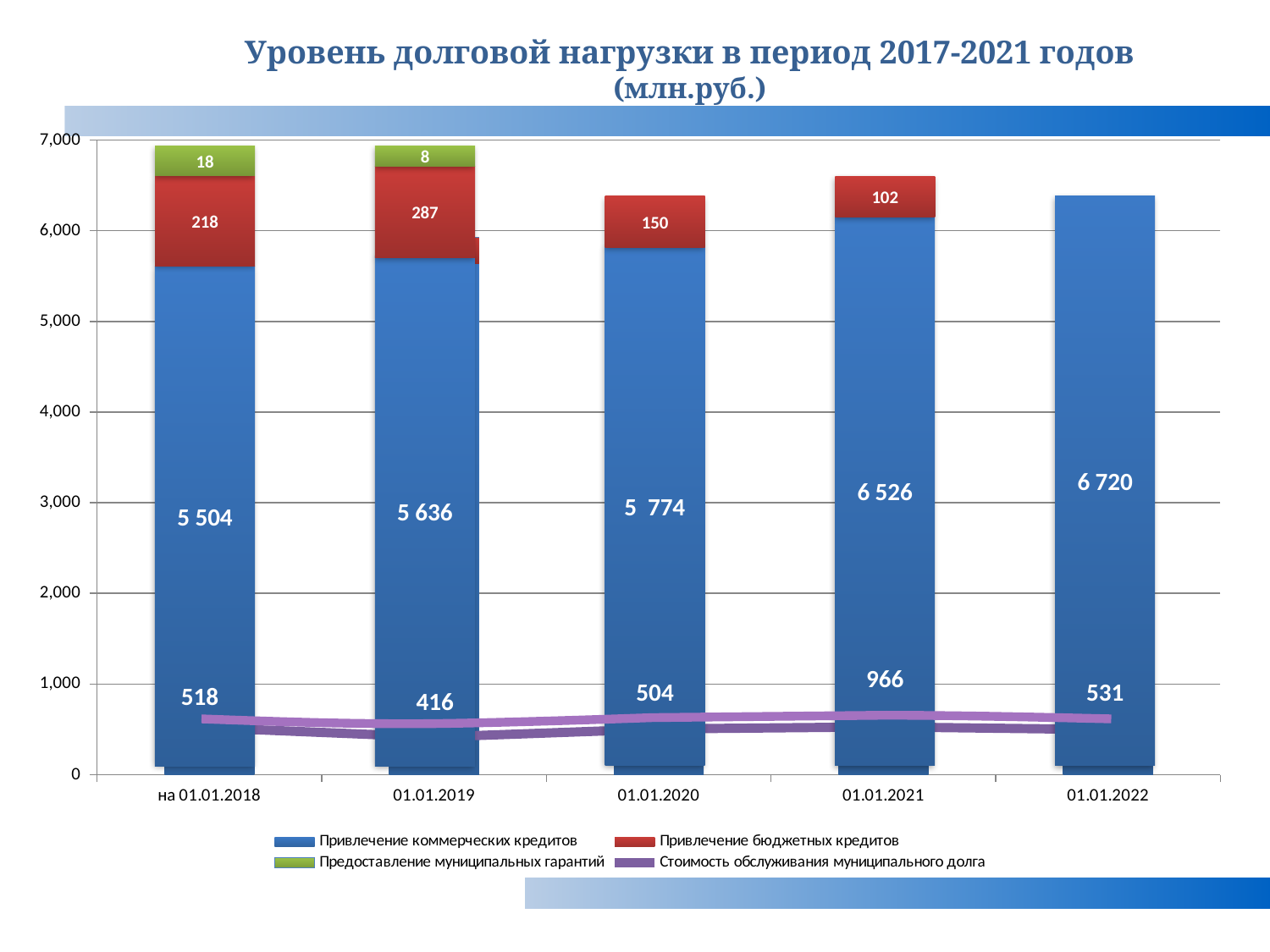
What kind of chart is shown on the slide? Combination bar and line chart What is the value of Привлечение коммерческих кредитов on 01.01.2022? 6 720 On which date is Привлечение коммерческих кредитов the highest? 01.01.2022 What is the value of Стоимость обслуживания муниципального долга on 01.01.2021? 966 On which date is Стоимость обслуживания муниципального долга the lowest? 01.01.2019 What is the value of Привлечение бюджетных кредитов on 01.01.2019? 287 Does Привлечение коммерческих кредитов rise or fall from 01.01.2018 to 01.01.2022? Rise How many dates are shown on the x axis? 5 Which is larger: Привлечение бюджетных кредитов on 01.01.2018 or on 01.01.2020? 01.01.2018 What is the value of Предоставление муниципальных гарантий on 01.01.2018? 18 By how much does Привлечение коммерческих кредитов on 01.01.2022 exceed the value on 01.01.2021? 194 How many series does the legend list? 4